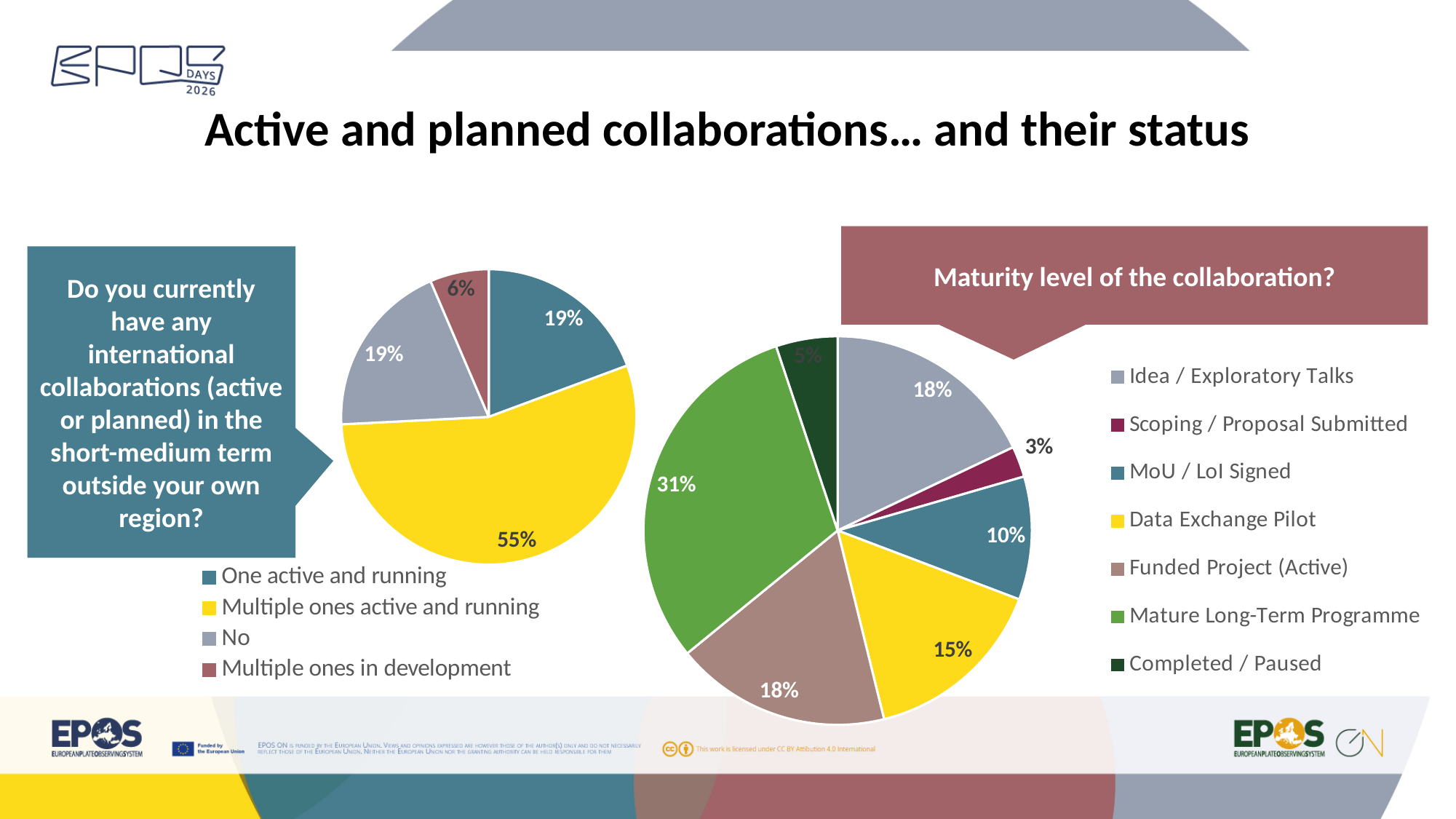
In the left pie chart about international collaborations, what share is 'Multiple ones active and running'? 55% In the 'Maturity level of the collaboration?' pie chart, which category has the largest share? Mature Long-Term Programme What type of chart is used for 'Maturity level of the collaboration?'? Pie chart In the left pie chart about international collaborations, what is the difference between 'Multiple ones active and running' and 'One active and running'? 36% In the left pie chart about international collaborations, which category has the smallest share? Multiple ones in development In the 'Maturity level of the collaboration?' pie chart, which category has the smallest share? Scoping / Proposal Submitted In the left pie chart about international collaborations, what share answered 'No'? 19% In the 'Maturity level of the collaboration?' pie chart, what share is 'Data Exchange Pilot'? 15% In the 'Maturity level of the collaboration?' pie chart, which is larger: 'MoU / LoI Signed' or 'Completed / Paused'? MoU / LoI Signed In the left pie chart about international collaborations, how many categories does the legend list? 4 In the 'Maturity level of the collaboration?' pie chart, how many categories does the legend list? 7